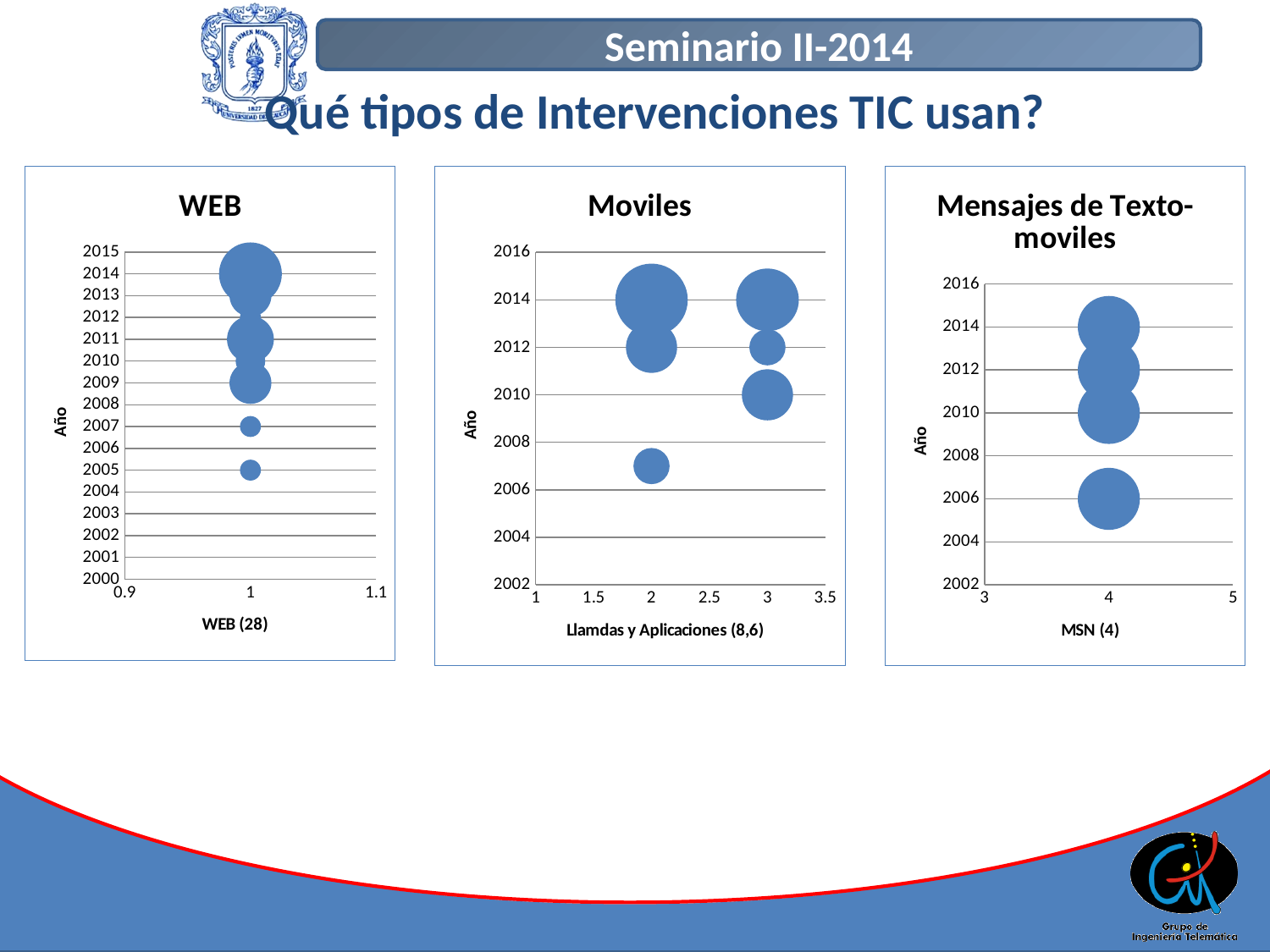
In the Moviles chart, is the earliest bubble's year greater or less than 2008? less In the Mensajes de Texto-moviles chart, what is the earliest year with a bubble? 2006 How many charts are shown on the slide? 3 In the WEB chart, what is the earliest year with a bubble? 2005 In the Mensajes de Texto-moviles chart, how many bubbles are plotted? 4 In the Mensajes de Texto-moviles chart, what is the latest year with a bubble? 2014 What kind of chart is the WEB chart? bubble chart In the Mensajes de Texto-moviles chart, what is the x-axis title? MSN (4) In the Moviles chart, which year has the largest bubbles? 2014 In the Moviles chart, what is the x-axis title? Llamadas y Aplicaciones (8,6)